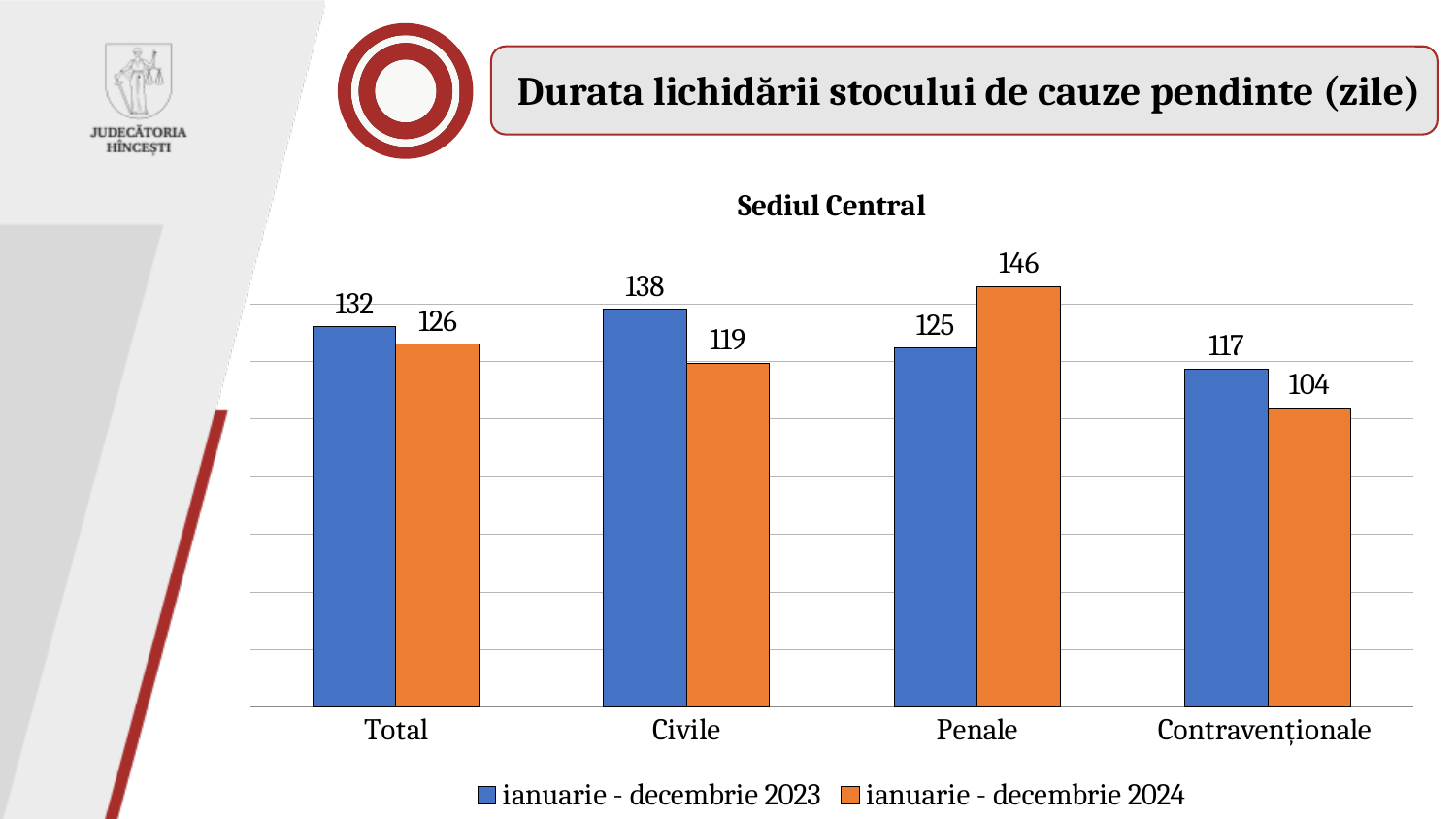
What is the title shown above the chart? Sediul Central Which category has the highest value in the ianuarie - decembrie 2024 series? Penale How many series does the legend list? 2 What is the value for Penale in the ianuarie - decembrie 2024 series? 146 What is the value for Civile in the ianuarie - decembrie 2023 series? 138 What is the value for Total in the ianuarie - decembrie 2024 series? 126 What is the value for Contravenționale in the ianuarie - decembrie 2023 series? 117 How many categories are shown on the x axis? 4 What kind of chart is shown on the slide? Bar chart For Penale, which series has the larger value: ianuarie - decembrie 2023 or ianuarie - decembrie 2024? ianuarie - decembrie 2024 Which category has the lowest value in the ianuarie - decembrie 2023 series? Contravenționale What is the difference between the 2023 and 2024 values for Civile? 19